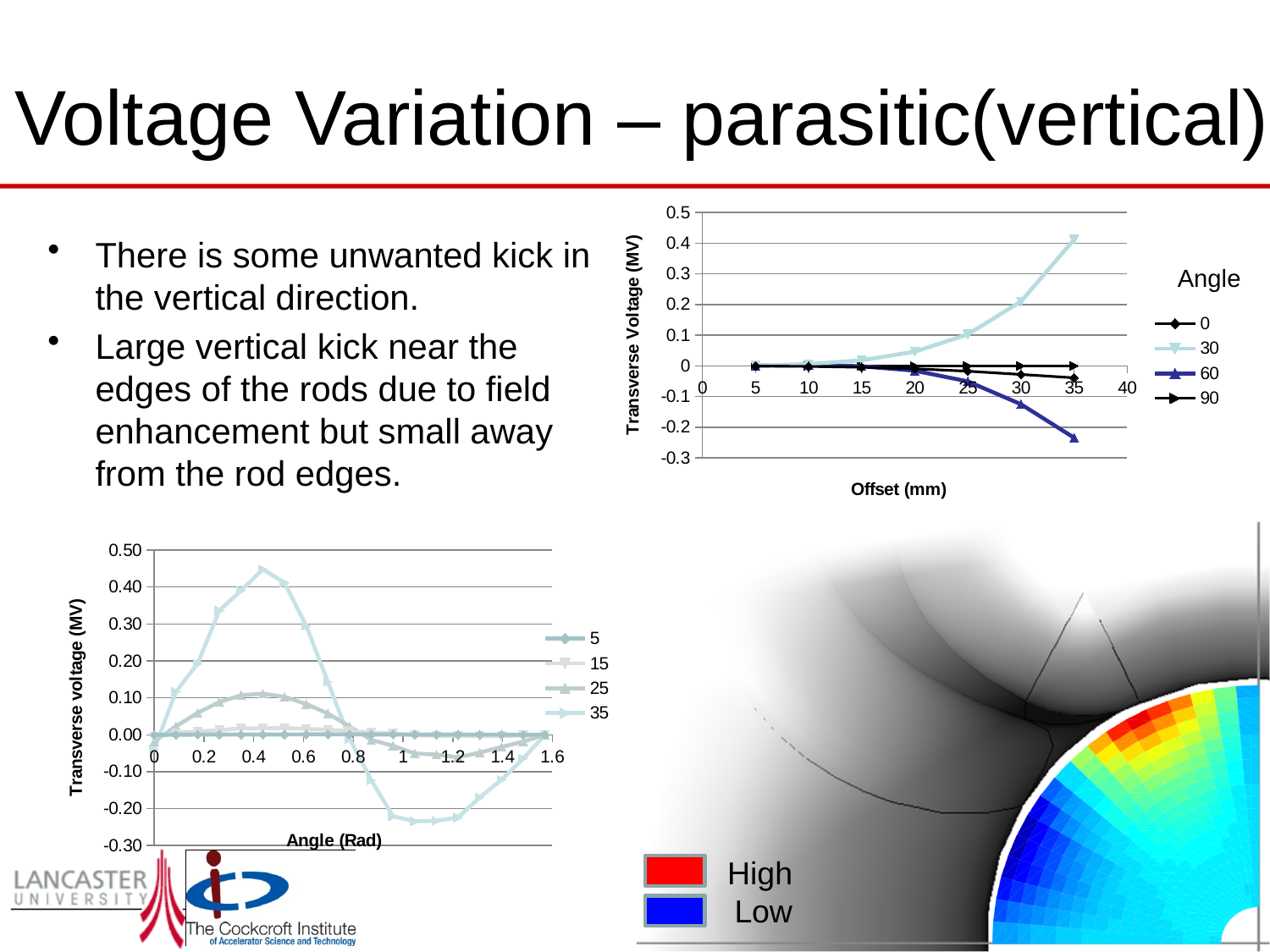
In the top-right chart (Transverse Voltage vs Offset), does the series for angle 30 rise or fall as the offset increases? rises In the bottom-left chart (Transverse voltage vs Angle), is the peak value of the series 35 greater or less than 0.30? greater In the top-right chart (Transverse Voltage vs Offset), what kind of chart is shown? line chart In the top-right chart (Transverse Voltage vs Offset), is the value for angle 30 at an offset of 35 mm greater or less than 0.3? greater In the top-right chart (Transverse Voltage vs Offset), at an offset of 35 mm, which series has the larger value, angle 30 or angle 60? 30 In the top-right chart (Transverse Voltage vs Offset), how many series does the legend list? 4 In the top-right chart (Transverse Voltage vs Offset), what is the title of the legend? Angle In the bottom-left chart (Transverse voltage vs Angle), which series reaches the highest transverse voltage? 35 In the bottom-left chart (Transverse voltage vs Angle), how many series does the legend list? 4 In the top-right chart (Transverse Voltage vs Offset), does the series for angle 60 rise or fall as the offset increases? falls In the bottom-left chart (Transverse voltage vs Angle), what is the x-axis title? Angle (Rad) In the top-right chart (Transverse Voltage vs Offset), is the value for angle 60 at an offset of 35 mm greater or less than -0.1? less